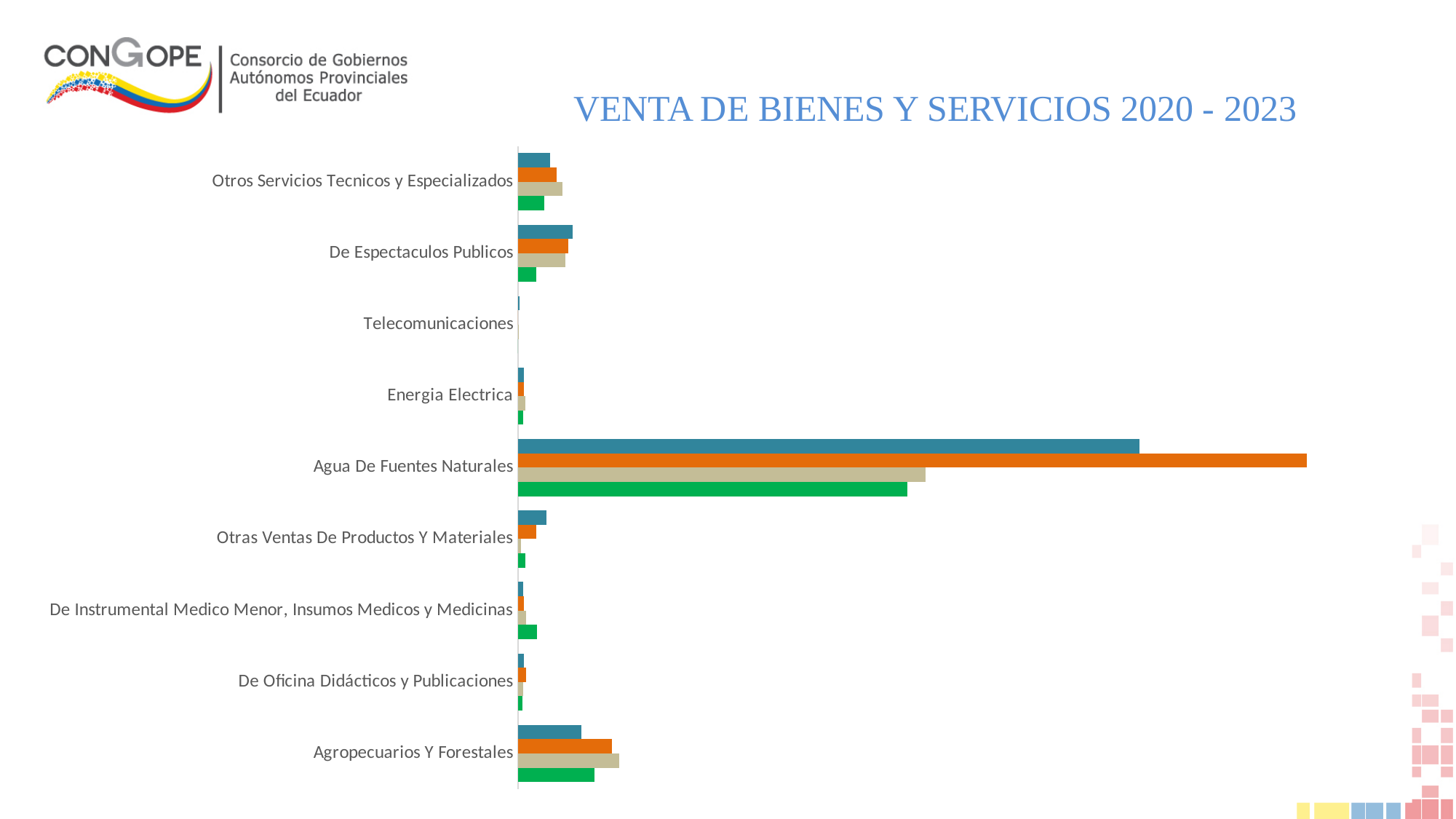
What is the title of the chart? VENTA DE BIENES Y SERVICIOS 2020 - 2023 Which category has larger values: Agua De Fuentes Naturales or Agropecuarios Y Forestales? Agua De Fuentes Naturales Which category has the shortest bars on the chart? Telecomunicaciones How many categories are shown on the chart's vertical axis? 9 Which category has the longest bars on the chart? Agua De Fuentes Naturales Which category has larger values: De Espectaculos Publicos or De Oficina Didácticos y Publicaciones? De Espectaculos Publicos For Agua De Fuentes Naturales, which coloured bar is the longest? The orange bar How many bars are drawn for each category on the chart? 4 What kind of chart is shown on the slide? Bar chart